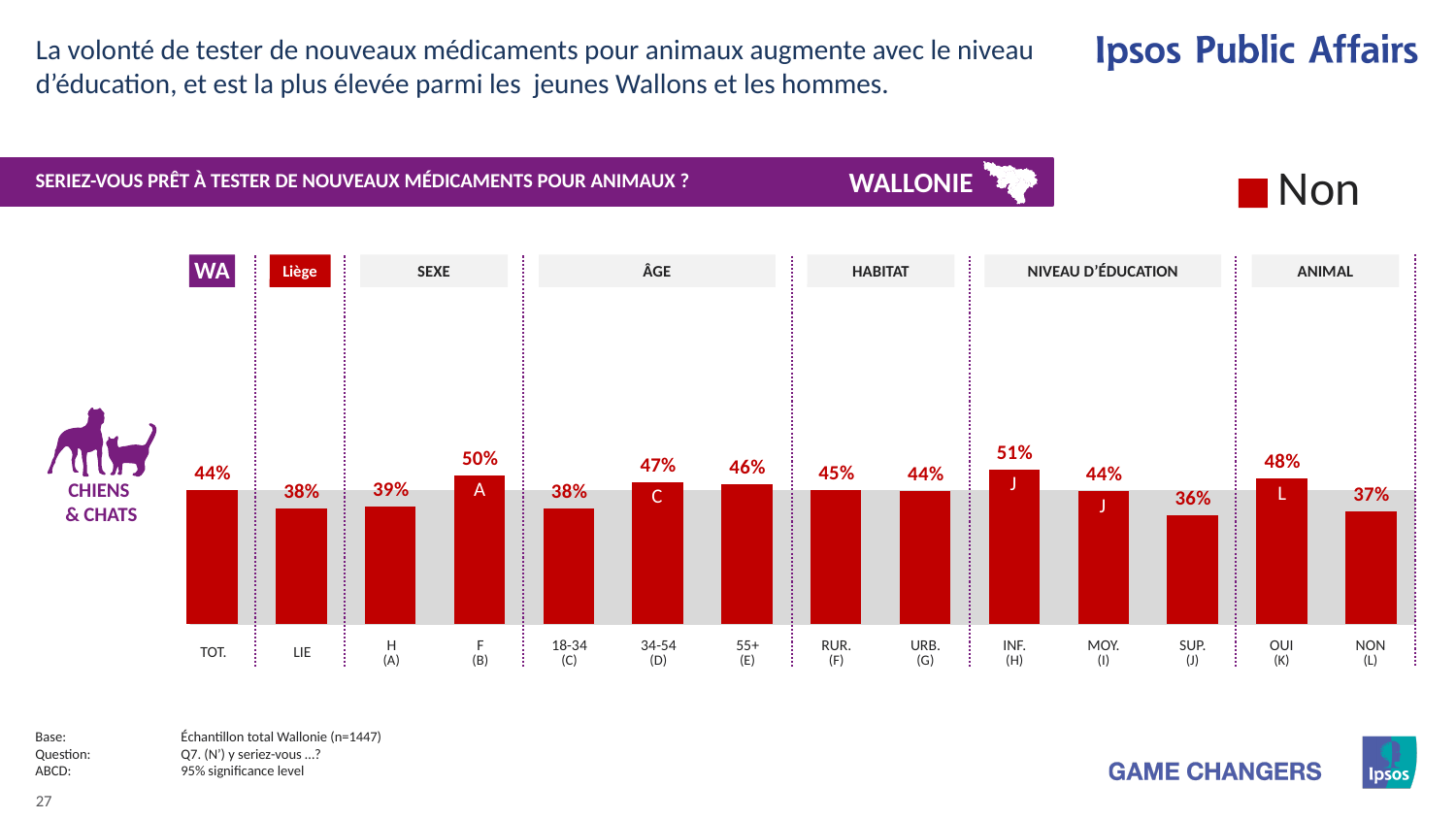
What is the difference between the values for F and H in the SEXE group? 11 percentage points What is the value for SUP. in the NIVEAU D'ÉDUCATION group? 36% What entry does the legend show? Non What is the value for F (women) in the SEXE group? 50% How many bars are plotted on the chart? 14 What is the difference between the values for INF. and SUP. in the NIVEAU D'ÉDUCATION group? 15 percentage points Which is larger, the value for OUI or the value for NON in the ANIMAL group? OUI What is the value for TOT. (total Wallonie)? 44% What is the value for the 18-34 age group? 38% Which category has the highest value on the chart? INF. (H) Which category has the lowest value on the chart? SUP. (J) What kind of chart is shown on the slide? Bar chart